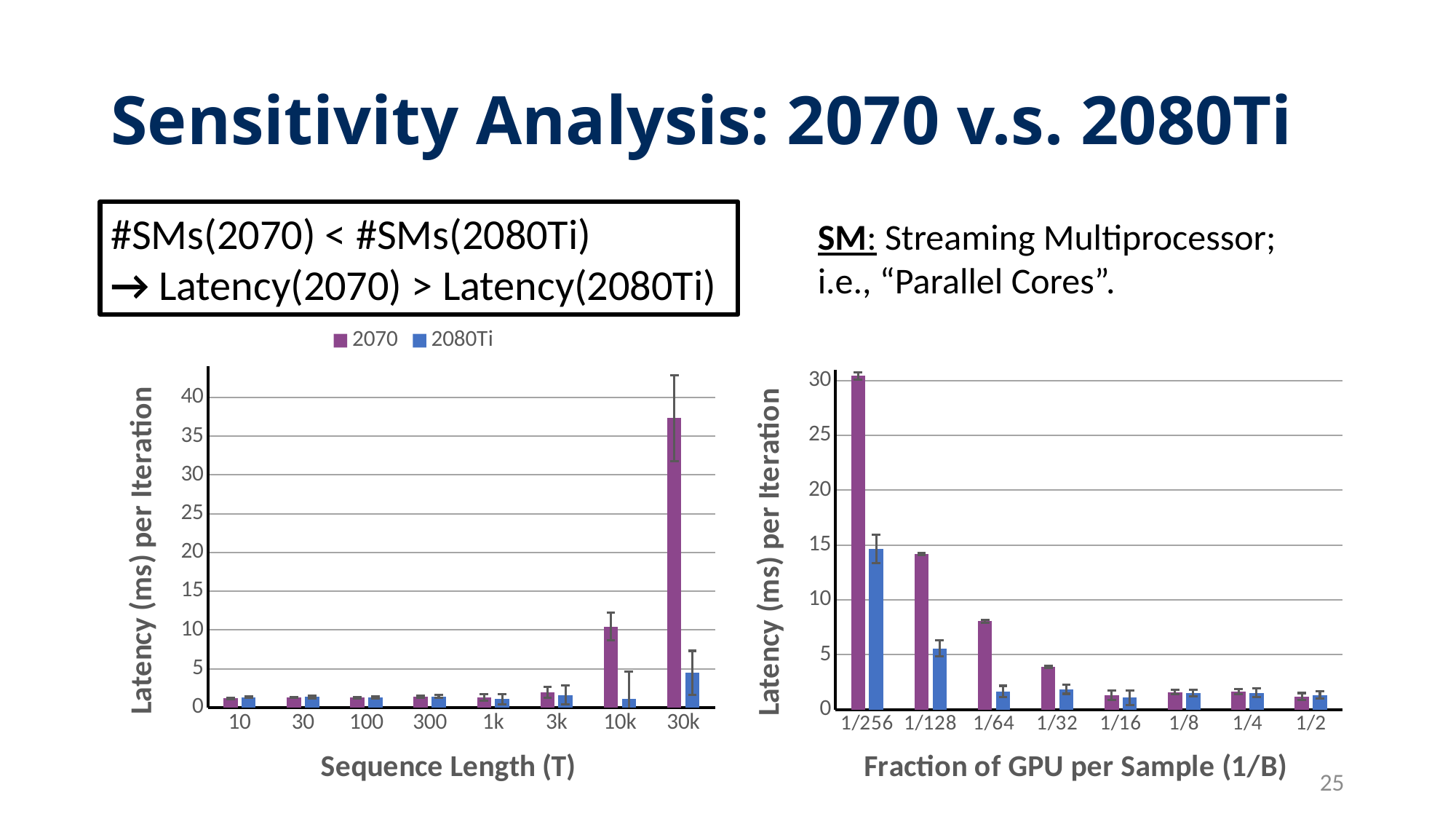
In the right chart (Fraction of GPU per Sample (1/B)), at which fraction is the 2070 latency highest? 1/256 How many series does the legend list? 2 In the left chart (Sequence Length (T)), is the 2080Ti value at 30k greater or less than 10? less In the left chart (Sequence Length (T)), how many sequence length categories are shown on the x axis? 8 In the right chart (Fraction of GPU per Sample (1/B)), does the 2070 latency rise or fall as the fraction goes from 1/256 to 1/2? fall In the right chart (Fraction of GPU per Sample (1/B)), how many categories are shown on the x axis? 8 What kind of chart is the left chart (Sequence Length (T))? bar chart In the left chart (Sequence Length (T)), at which sequence length is the 2070 latency highest? 30k What is the y-axis label of the right chart (Fraction of GPU per Sample (1/B))? Latency (ms) per Iteration In the right chart (Fraction of GPU per Sample (1/B)), is the 2070 value at 1/256 greater or less than 25? greater In the left chart (Sequence Length (T)), which series has the larger value at 10k, 2070 or 2080Ti? 2070 In the left chart (Sequence Length (T)), is the 2070 value at 30k greater or less than 35? greater